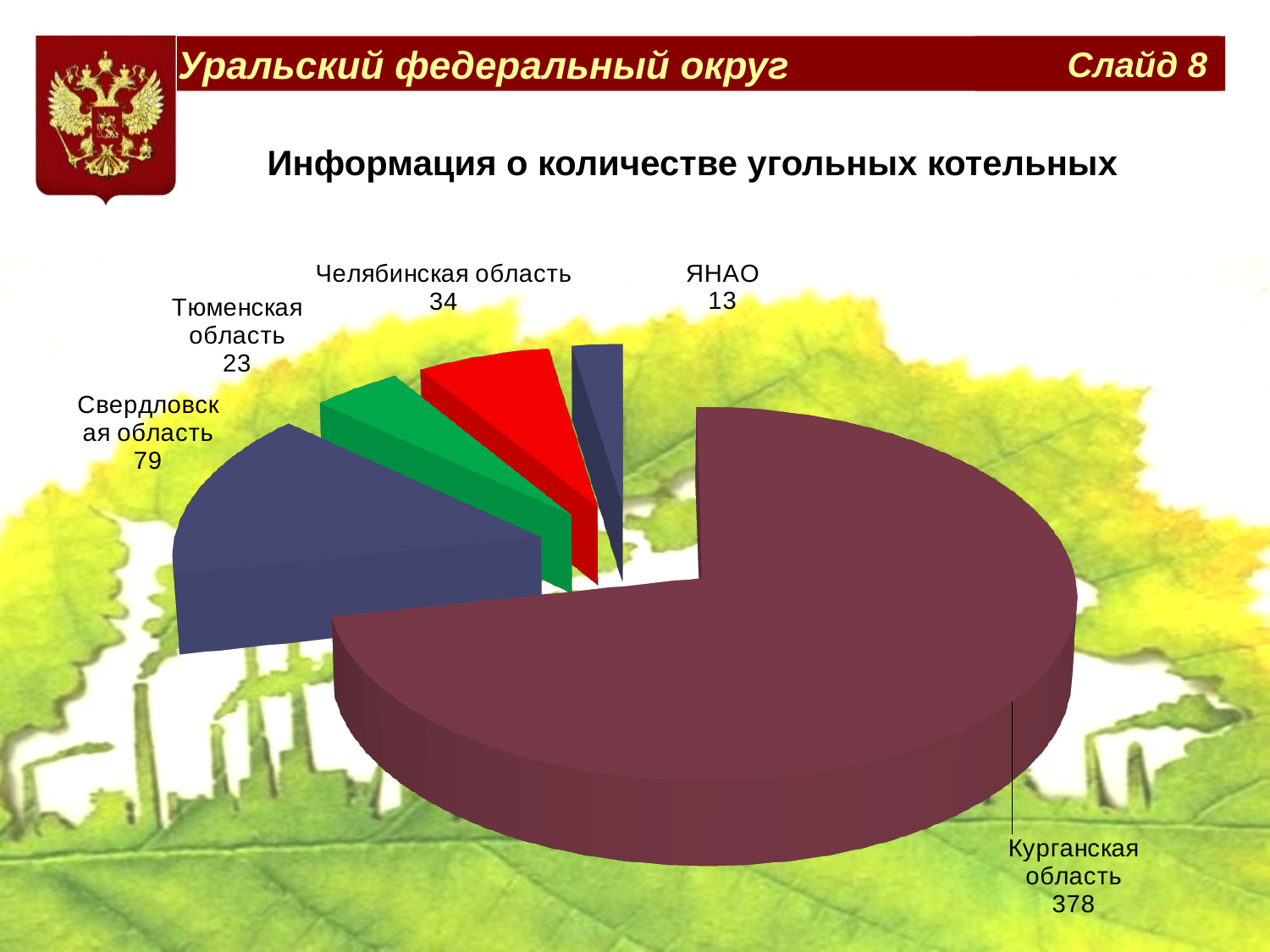
How many regions (slices) are shown in the pie chart? 5 How many coal boiler houses are shown for Курганская область? 378 Which is larger, the value for Челябинская область or the value for Тюменская область? Челябинская область Which region has the largest slice of the pie? Курганская область What is the value shown for ЯНАО? 13 Which region has the smallest slice of the pie? ЯНАО What type of chart is shown on the slide? pie chart What is the value shown for Свердловская область? 79 What is the title of the chart on the slide? Информация о количестве угольных котельных What is the total of all values shown in the pie chart? 527 What is the value shown for Челябинская область? 34 What is the difference between the values for Свердловская область and Тюменская область? 56